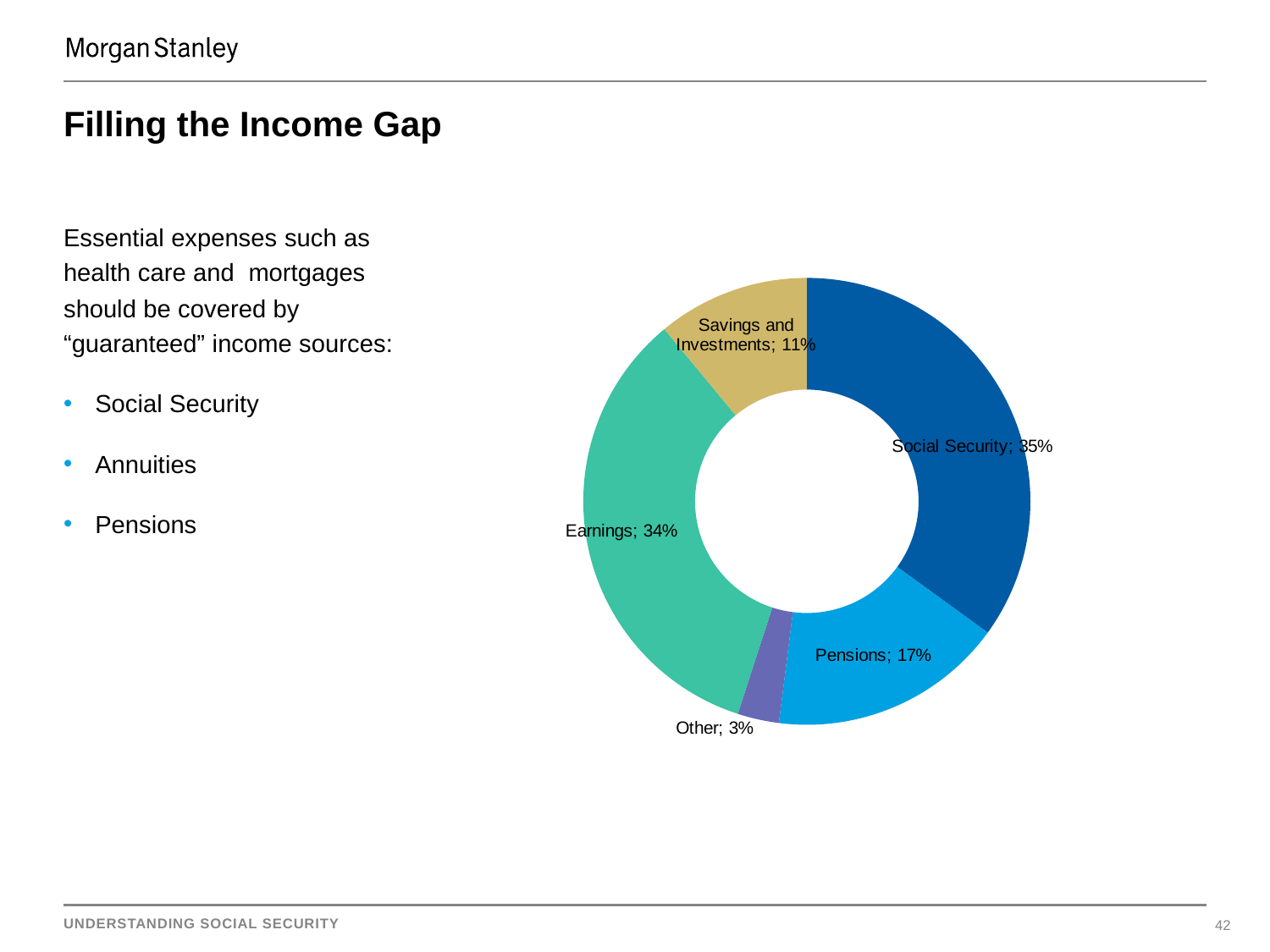
What is the title of the slide containing the chart? Filling the Income Gap What percentage is shown for Savings and Investments? 11% What is the value shown for Pensions? 17% Which category has the largest slice? Social Security Which category has the smallest slice? Other What is the difference in percentage points between Earnings and Other? 31 What share of the pie does Social Security represent? 35% What is the difference in percentage points between Social Security and Pensions? 18 How many categories are shown in the chart? 5 What is the value shown for Earnings? 34% Which is larger, the slice for Pensions or the slice for Savings and Investments? Pensions What kind of chart is shown on the slide? doughnut chart